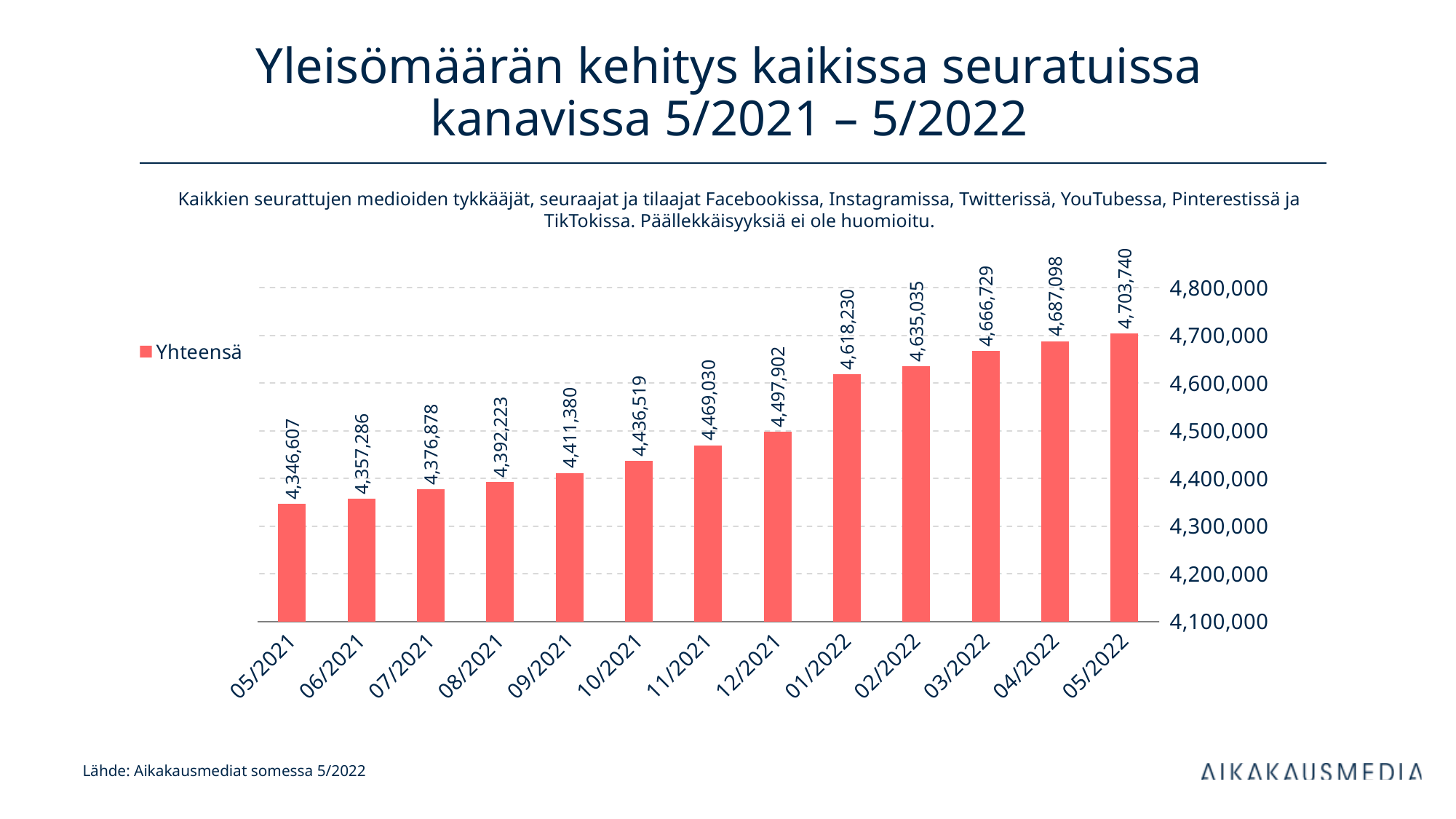
Which month has the highest value? 05/2022 Which month has the lowest value? 05/2021 What is the value for 05/2021? 4,346,607 Which is larger, the value for 09/2021 or the value for 11/2021? 11/2021 What is the value for 05/2022? 4,703,740 What is the value for 01/2022? 4,618,230 What kind of chart is shown? bar chart What is the difference between the values for 05/2022 and 05/2021? 357,133 What is the difference between the values for 01/2022 and 12/2021? 120,328 Is the value for 03/2022 greater or less than 4,600,000? greater How many months are shown on the x axis? 13 Do the values rise or fall from 05/2021 to 05/2022? rise